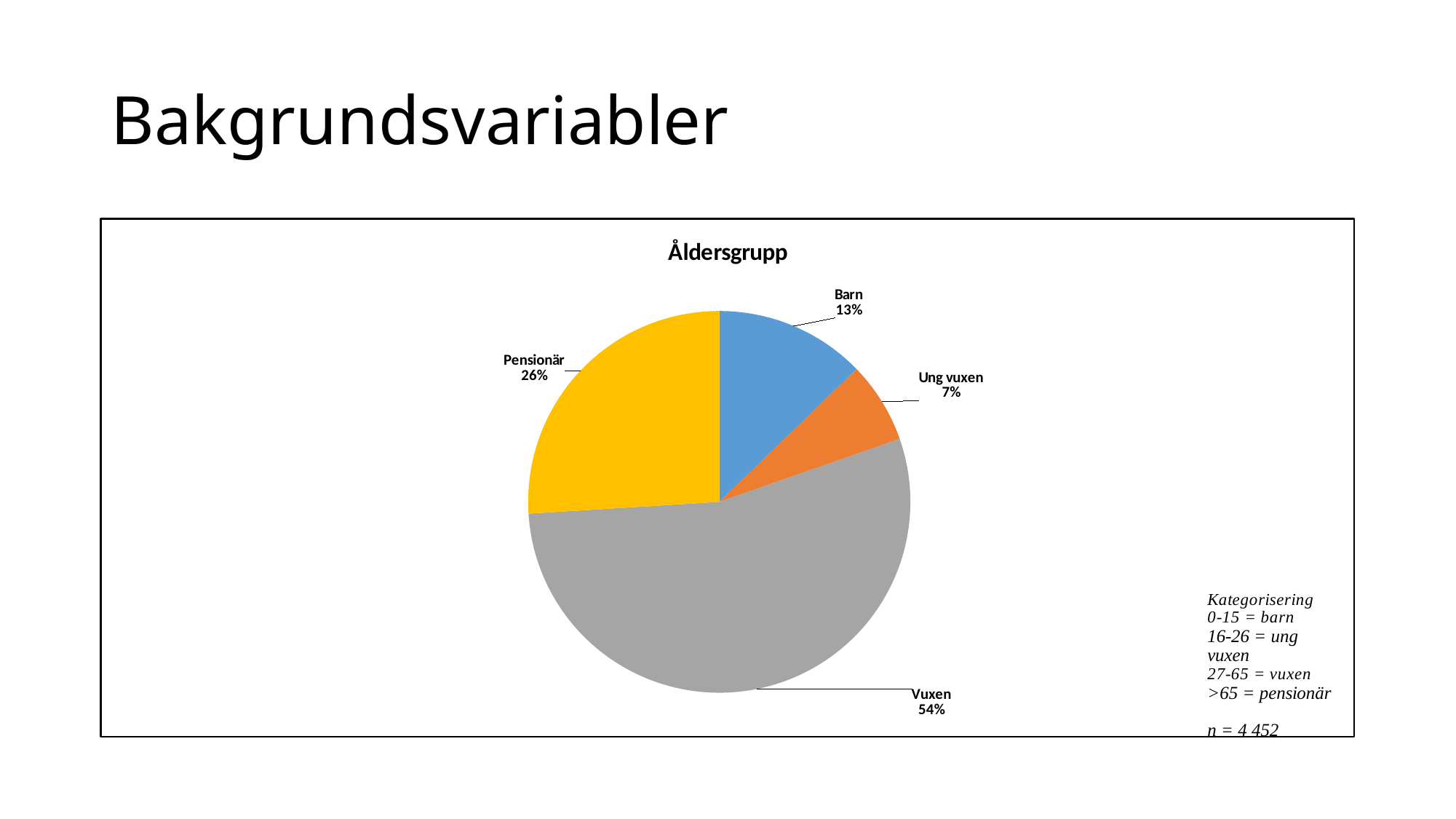
How many slices does the pie chart have? 4 What colour is the Vuxen slice? grey Which age group has the largest slice of the pie? Vuxen What share of the pie does Ung vuxen represent? 7% What kind of chart is shown on the slide? pie chart What share of the pie does Vuxen represent? 54% Which age group has the smallest slice of the pie? Ung vuxen What is the difference in percentage points between Vuxen and Pensionär? 28 What share of the pie does Barn represent? 13% Which is larger, the share for Barn or the share for Ung vuxen? Barn What is the title of the chart? Åldersgrupp